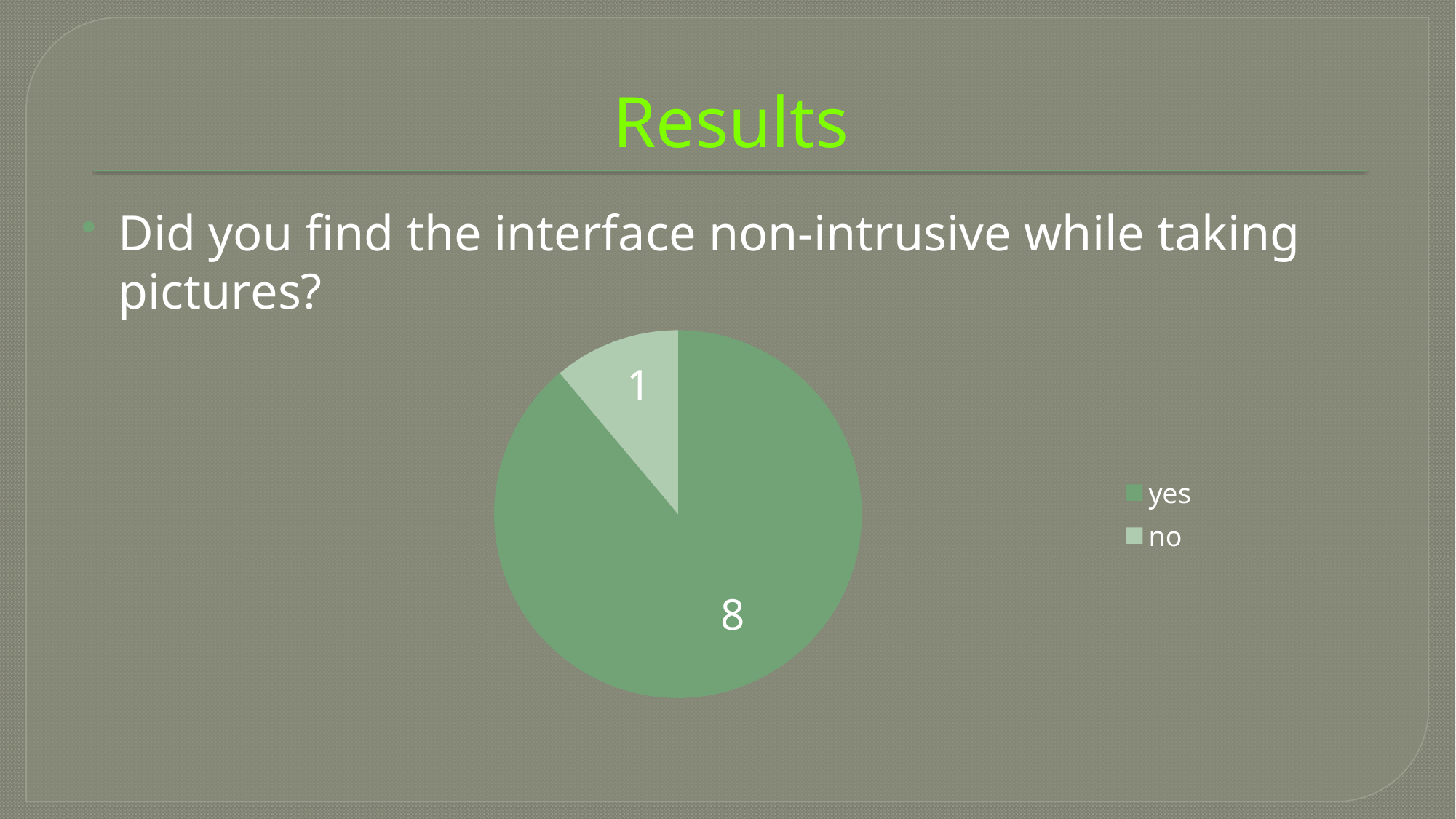
What is the difference between the number of "yes" and "no" responses? 7 Which legend entry is shown in the lighter green colour? no What is the total number of responses shown in the pie chart? 9 Which is larger, the "yes" slice or the "no" slice? yes How many slices does the pie chart have? 2 How many respondents answered "no"? 1 What kind of chart is shown on the slide? pie chart Which response has the smallest slice of the pie? no What share of the total responses does the "no" slice represent? 1 out of 9 How many respondents answered "yes"? 8 How many entries does the legend list? 2 Which response has the largest slice of the pie? yes